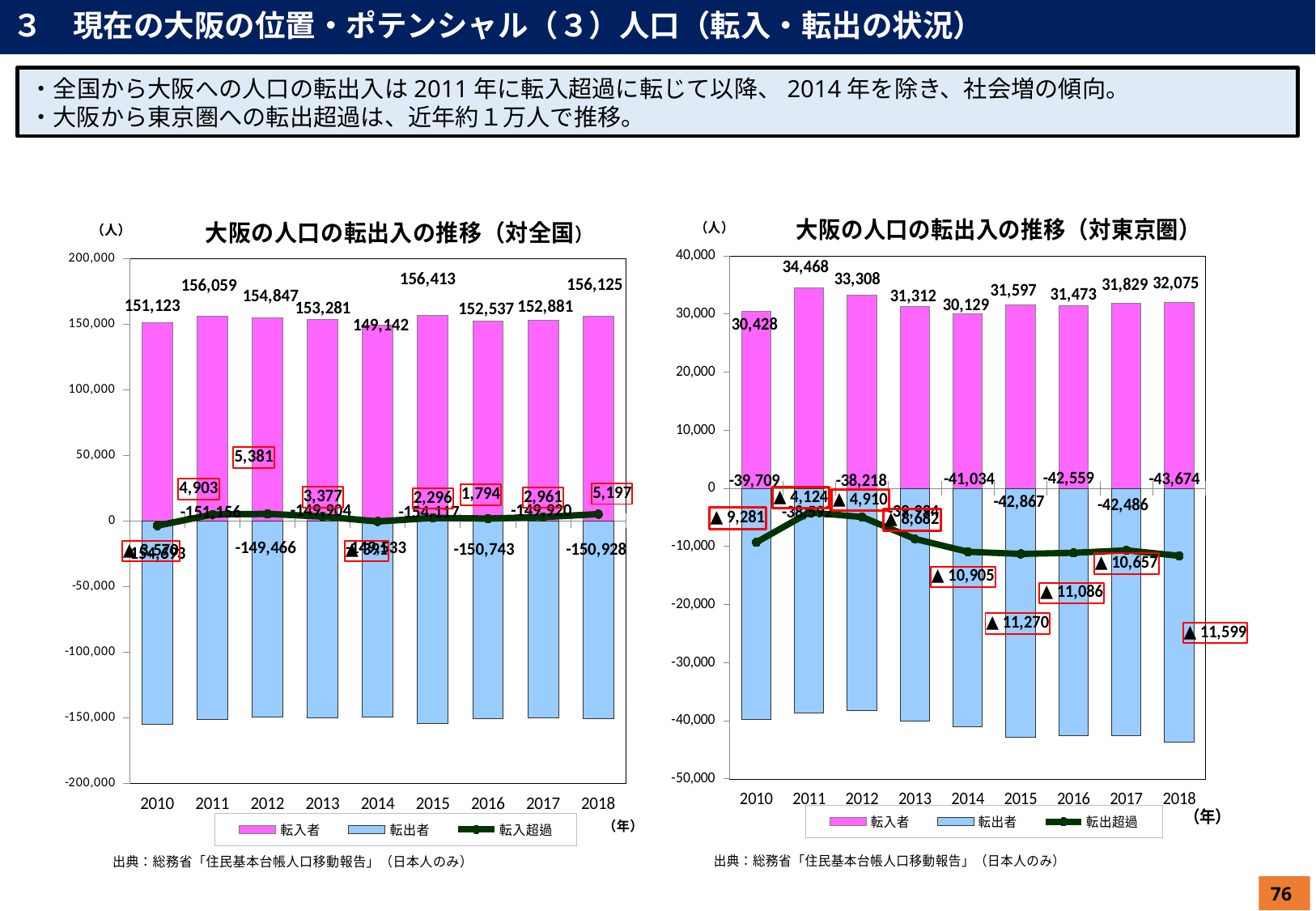
In the right chart (大阪の人口の転出入の推移（対東京圏）), what is the 転入者 value for 2011? 34,468 In the right chart (対東京圏), is the 転入者 value for 2018 larger or smaller than the 転入者 value for 2014? larger How many series does the legend of the left chart (対全国) list? 3 In the left chart (対全国), what is the difference between the 転入者 values for 2011 and 2010? 4,936 In the left chart (対全国), which year has the lowest 転入者 value? 2014 In the left chart (対全国), which year has the highest 転入者 value? 2015 In the right chart (対東京圏), what is the 転出者 value for 2018? -43,674 In the right chart (対東京圏), which year has the highest 転入者 value? 2011 In the left chart (大阪の人口の転出入の推移（対全国）), what is the value of 転入者 for 2015? 156,413 In the left chart (対全国), what is the 転入超過 value for 2012? 5,381 In the right chart (対東京圏), what is the 転出超過 value for 2015? ▲ 11,270 How many years are shown on the x axis of the right chart (対東京圏)? 9